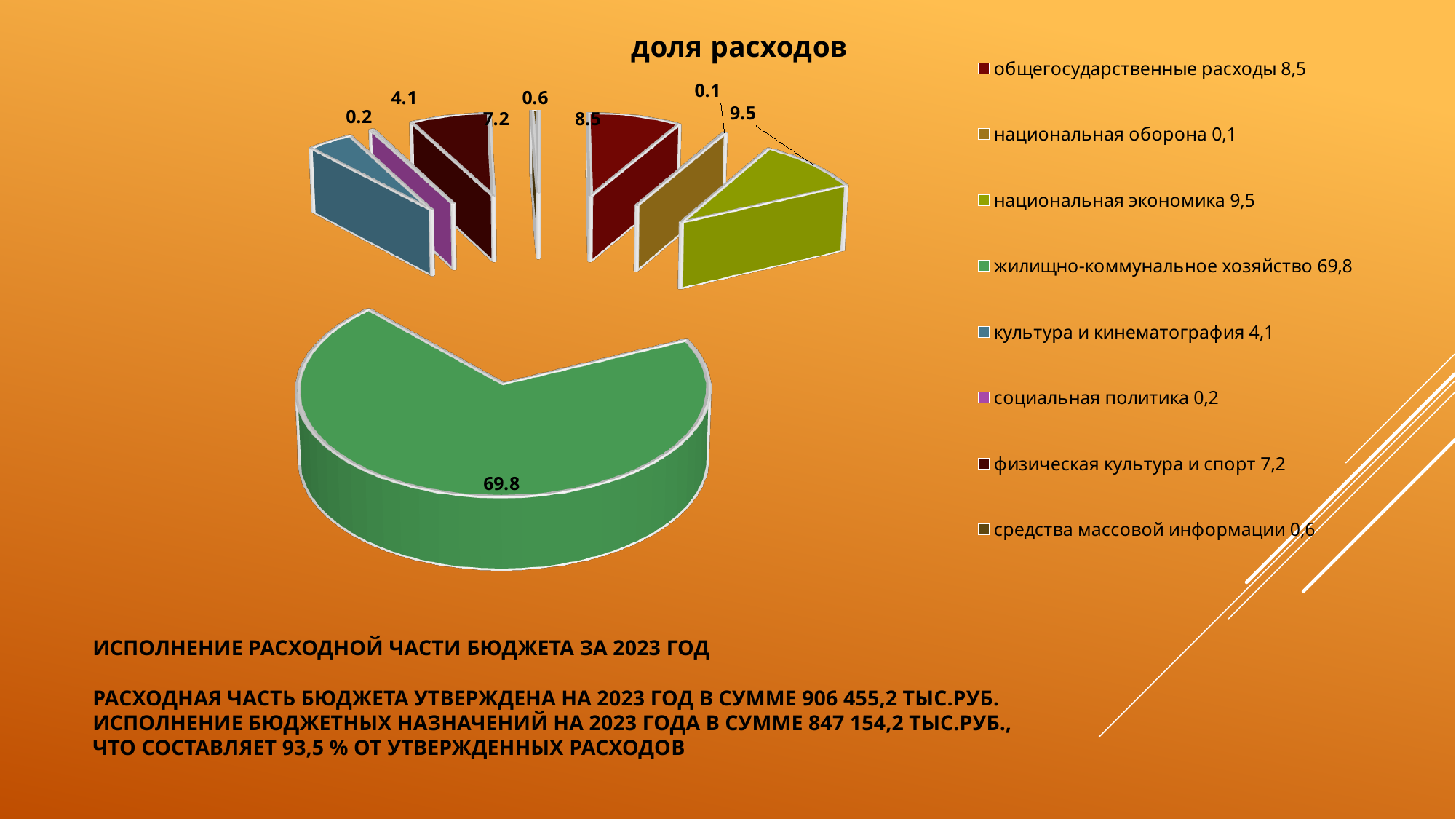
What is the value for культура и кинематография? 4,1 Which is larger: общегосударственные расходы or национальная экономика? национальная экономика What is the title of the chart? доля расходов Which category has the largest share of expenses? жилищно-коммунальное хозяйство Which category has the smallest share of expenses? национальная оборона What is the value for физическая культура и спорт? 7,2 Which is larger: социальная политика or средства массовой информации? средства массовой информации What is the difference between the values for жилищно-коммунальное хозяйство and физическая культура и спорт? 62,6 What is the value for национальная экономика? 9,5 What kind of chart is shown on the slide? pie chart What is the difference between the values for национальная экономика and общегосударственные расходы? 1 How many slices does the pie chart have? 8